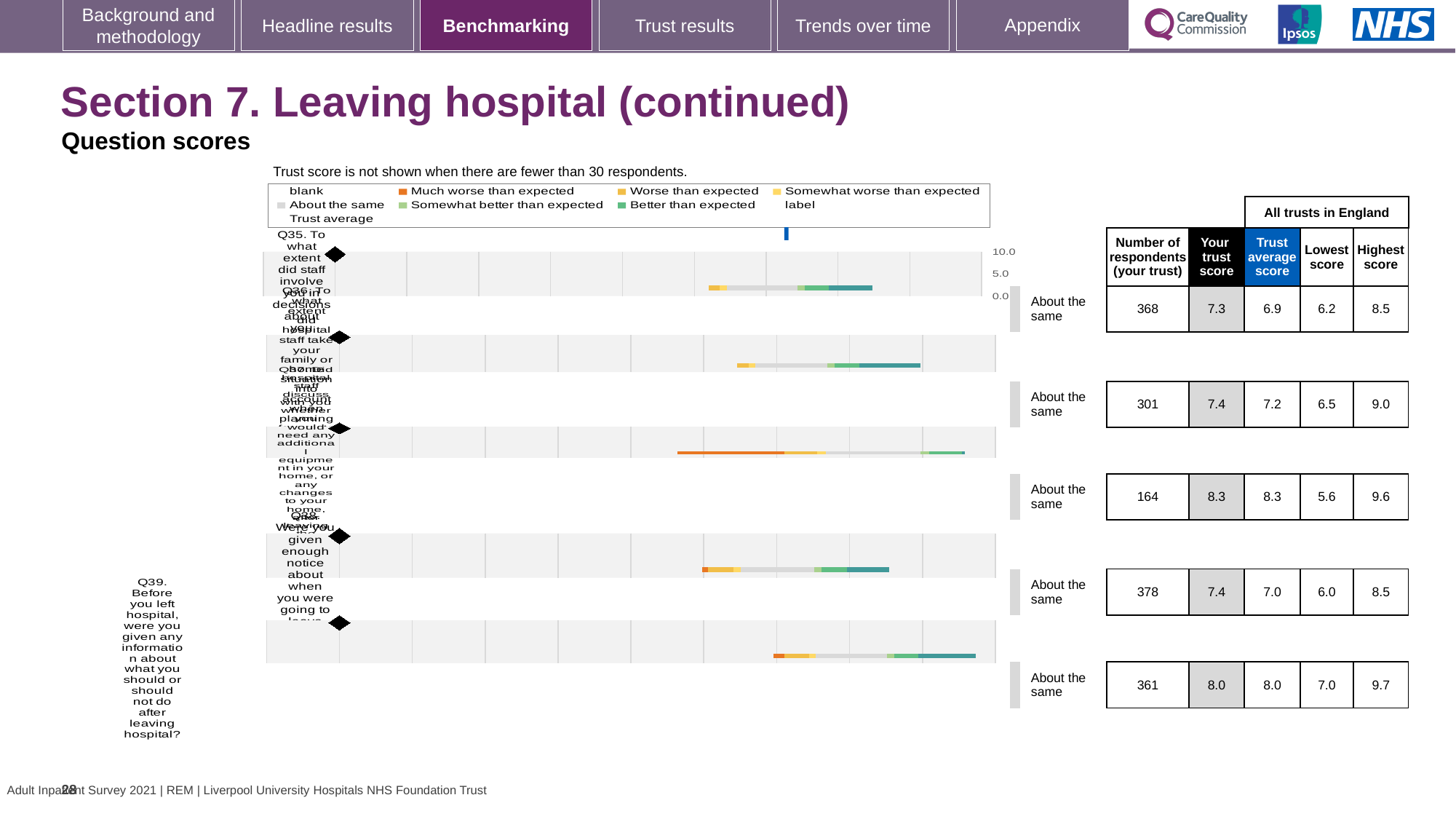
What is the trust average score for Q35, the first question row? 6.9 How many question rows are shown in the chart? 5 What is the number of respondents (your trust) for Q35, the first question row? 368 What benchmark category is shown for every question row on this slide? About the same What kind of chart is used to show the question scores? Bar chart What is the trust score for Q39, the last question row? 8.0 Which question row has the lowest 'Lowest score' value? Q37 (third row), 5.6 For the second question row (Q36), which is larger: the trust score or the trust average score? Trust score (7.4) Which question row has the fewest respondents? Q37 (third row), 164 What is the difference between the trust score and the trust average score for Q35, the first question row? 0.4 Which question row has the highest 'Highest score' value? Q39 (last row), 9.7 Is the trust score for Q37, the third question row, greater or less than 5.0? greater